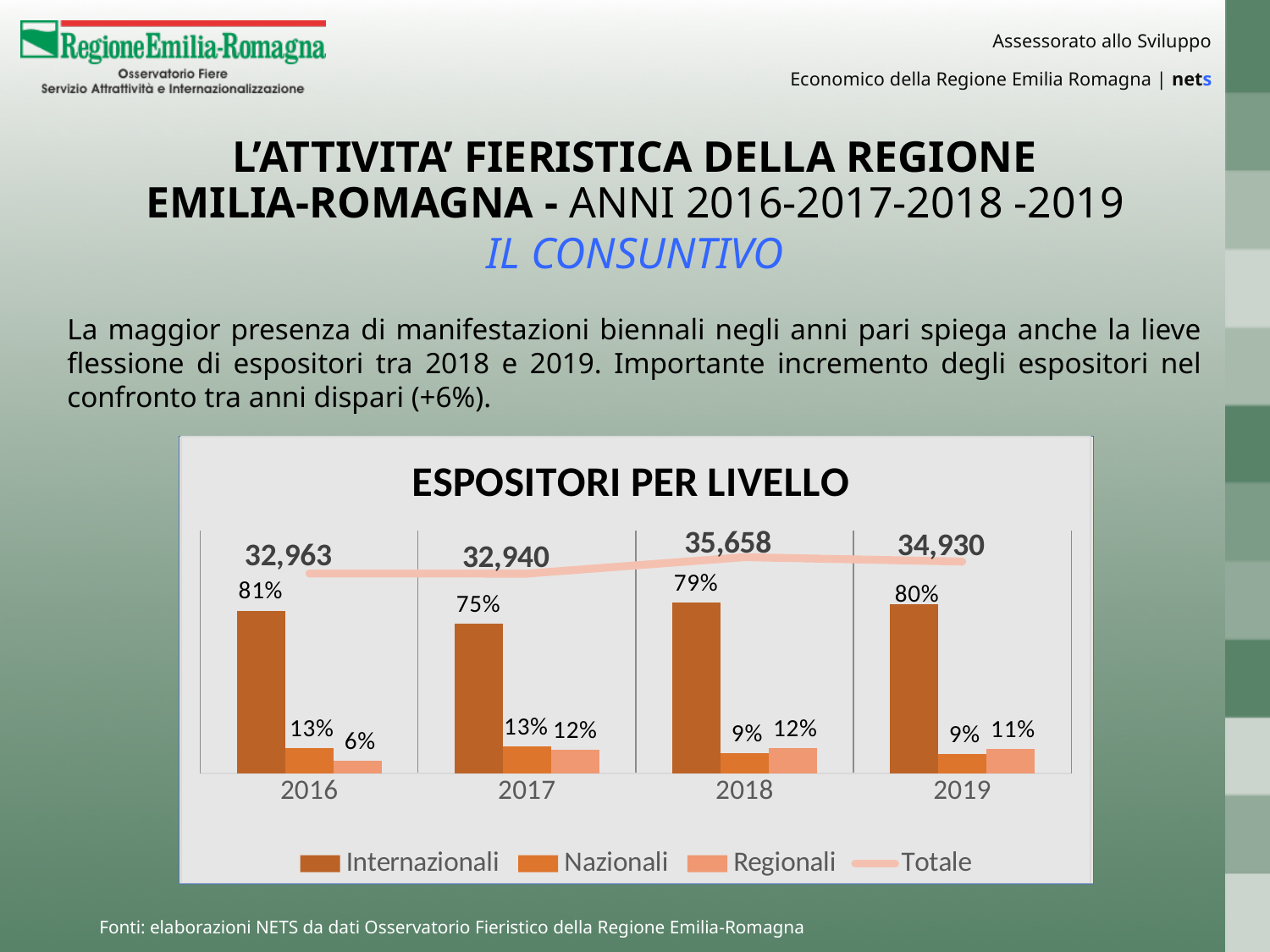
What is the Nazionali share of exhibitors in 2019? 9% What is the Totale value shown for 2018? 35,658 In which year is the Totale value highest? 2018 How many series does the chart legend list? 4 What is the difference between the Totale values for 2018 and 2019? 728 What is the Internazionali share of exhibitors in 2016? 81% Which is larger, the Regionali share in 2016 or the Regionali share in 2019? 2019 What is the Regionali share of exhibitors in 2017? 12% How many years are shown on the x axis of the chart? 4 What is the title of the chart on the slide? ESPOSITORI PER LIVELLO Does the Nazionali share rise or fall from 2016 to 2019? fall In which year is the Internazionali share lowest? 2017